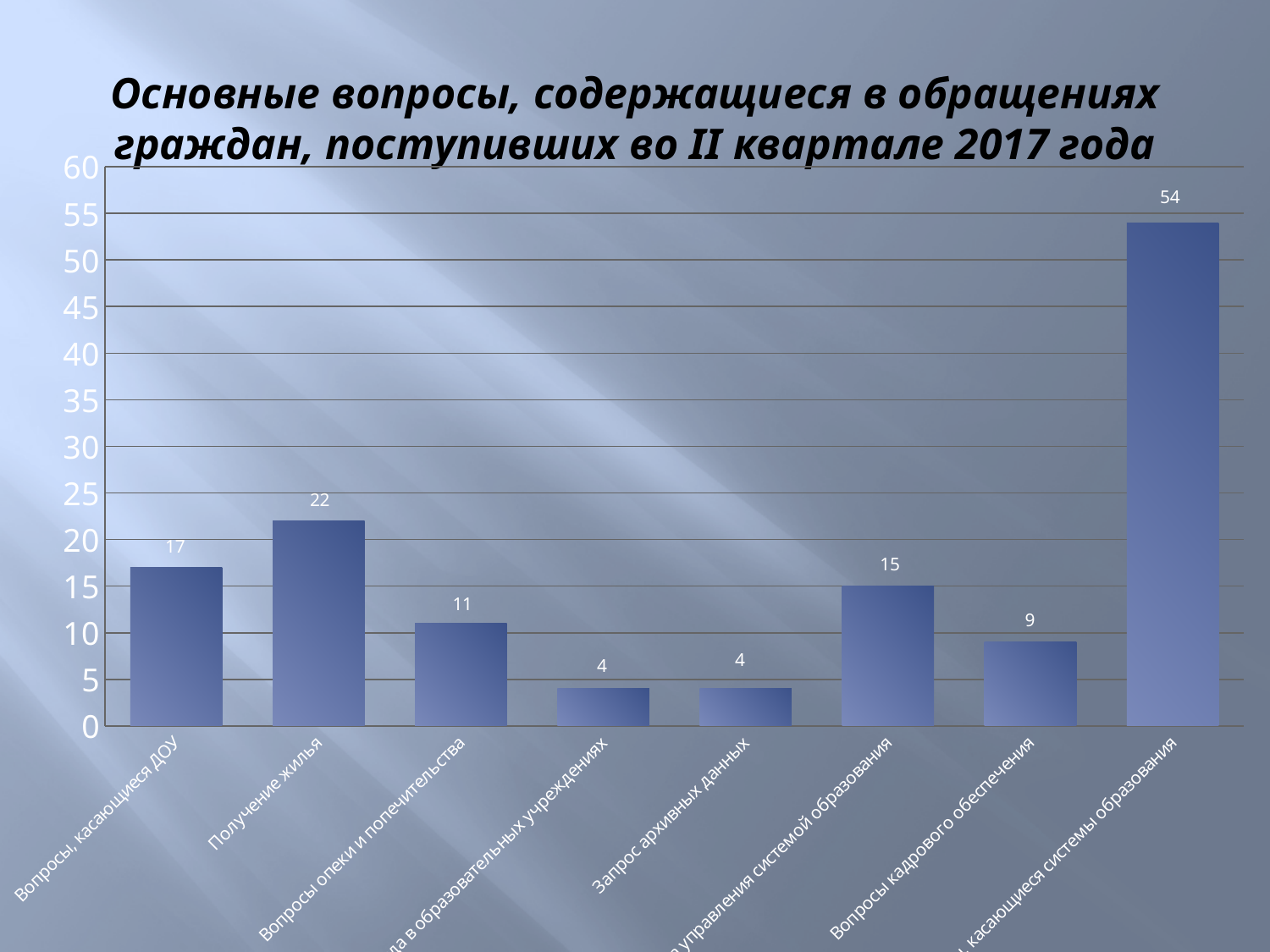
What type of chart is shown on the slide? Bar chart What is the value for "Вопросы, касающиеся ДОУ"? 17 What is the value for "Получение жилья"? 22 Which is larger: the value for "Вопросы опеки и попечительства" or the value for "Вопросы кадрового обеспечения"? Вопросы опеки и попечительства What is the value for "Запрос архивных данных"? 4 What is the value for "Вопросы кадрового обеспечения"? 9 What is the title of the chart? Основные вопросы, содержащиеся в обращениях граждан, поступивших во II квартале 2017 года How many bars (categories) does the chart show? 8 Is the value for "Получение жилья" greater or less than 20? greater What is the value for "Вопросы опеки и попечительства"? 11 What is the highest value shown on the chart? 54 What is the difference between the values for "Получение жилья" and "Вопросы, касающиеся ДОУ"? 5